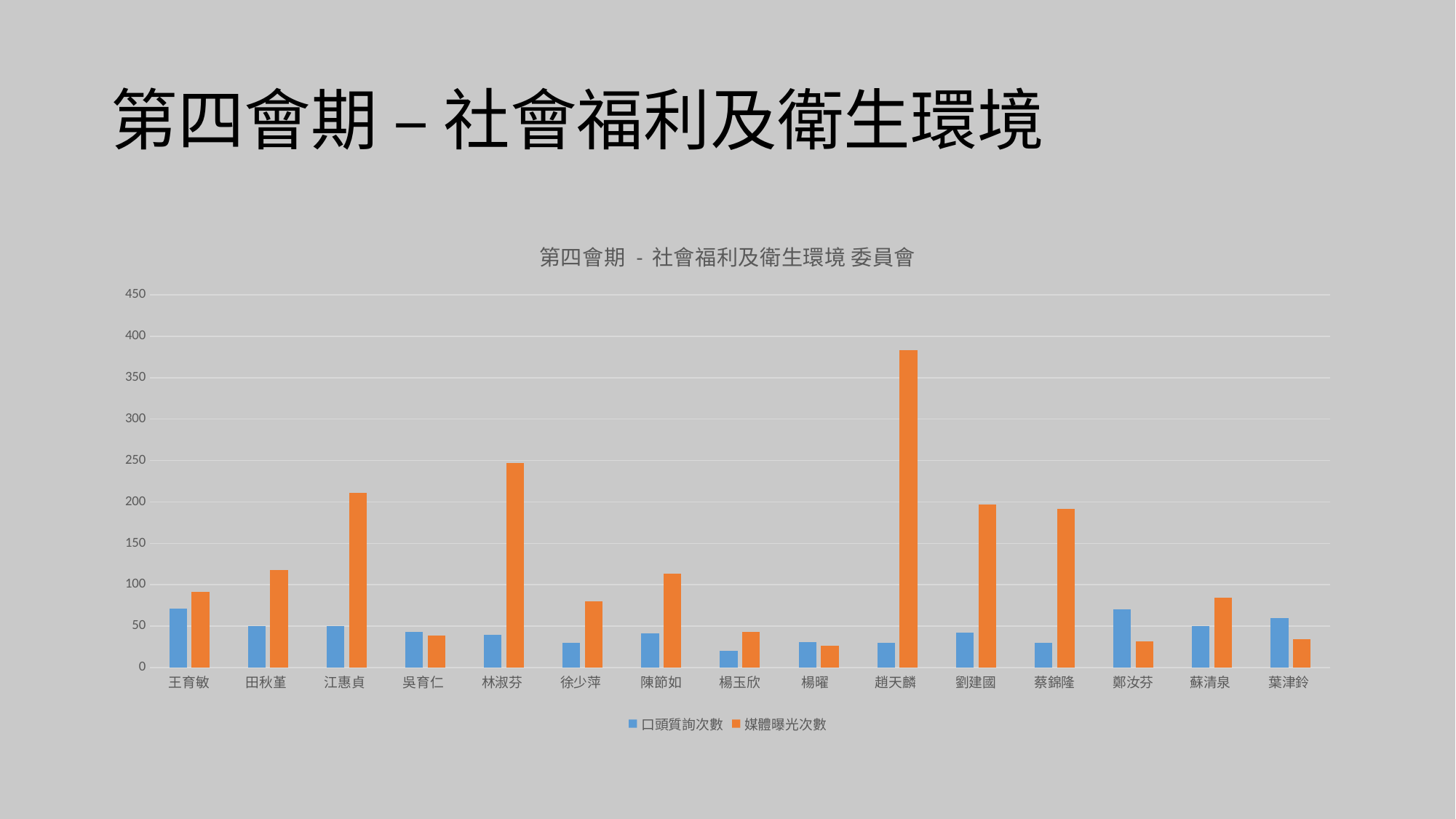
Is the 口頭質詢次數 value for 楊玉欣 greater or less than 50? less What kind of chart is shown on the slide? bar chart How many series does the legend list? 2 Is the 媒體曝光次數 value for 林淑芬 greater or less than 200? greater Which legislator has the larger 媒體曝光次數: 趙天麟 or 林淑芬? 趙天麟 How many legislators (categories) are shown on the x axis? 15 Which colour represents 媒體曝光次數 in the chart? orange Is the 媒體曝光次數 value for 趙天麟 greater or less than 350? greater Which is larger for 鄭汝芬: 口頭質詢次數 or 媒體曝光次數? 口頭質詢次數 Which legislator has the highest 媒體曝光次數? 趙天麟 What is the title of the chart? 第四會期 - 社會福利及衛生環境 委員會